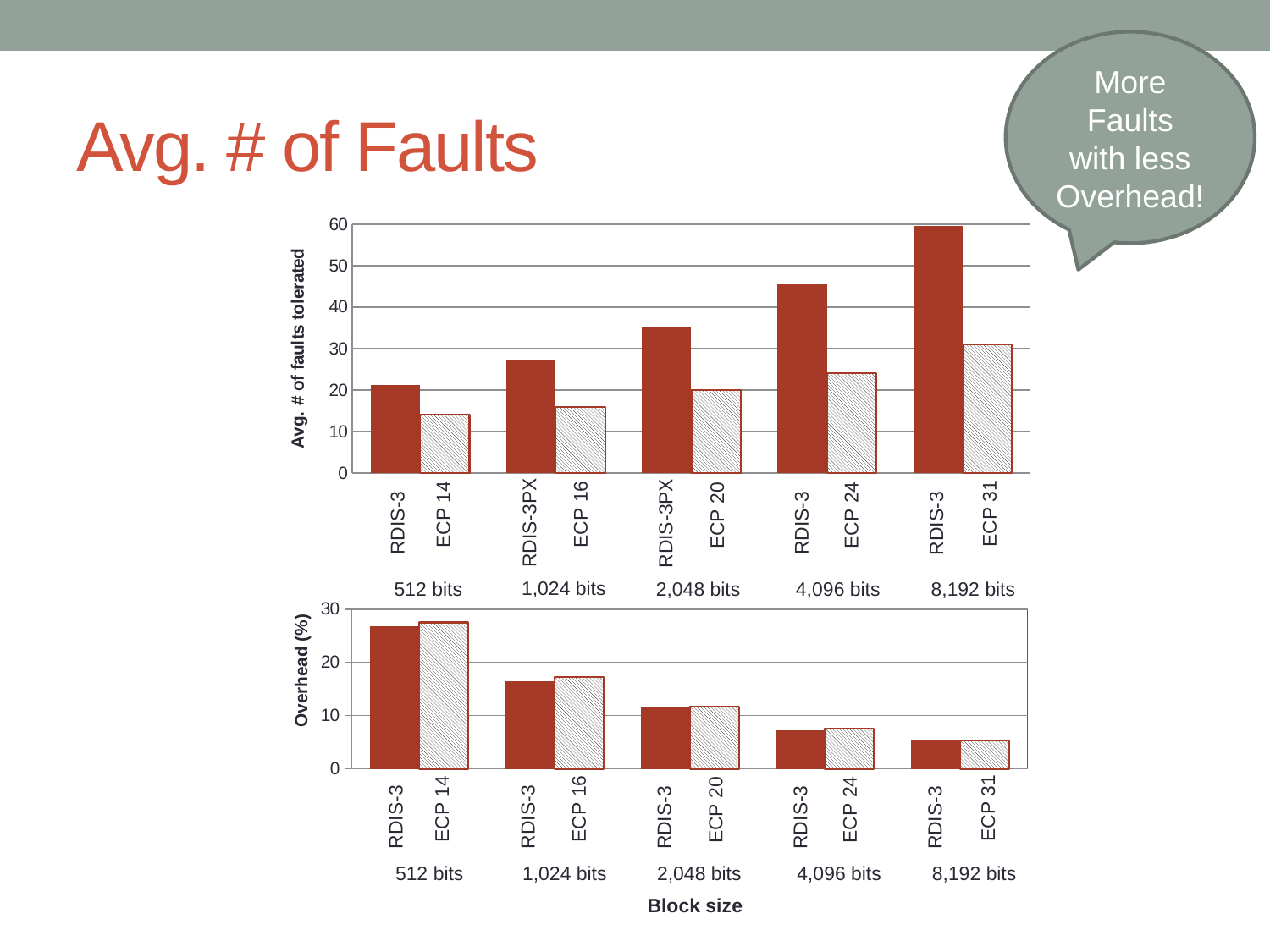
In the top chart (Avg. # of faults tolerated), at 4,096 bits, which tolerates more faults: RDIS-3 or ECP 24? RDIS-3 In the top chart (Avg. # of faults tolerated), is the value for RDIS-3 at 8,192 bits greater or less than 50? greater In the top chart (Avg. # of faults tolerated), how many block sizes are shown along the x axis? 5 What is the x-axis title shown below the bottom chart? Block size In the top chart (Avg. # of faults tolerated), which bar is the lowest? ECP 14 at 512 bits In the bottom chart (Overhead (%)), does overhead rise or fall as block size increases? fall What kind of chart is the top chart (Avg. # of faults tolerated)? bar chart In the bottom chart (Overhead (%)), is the value for RDIS-3 at 512 bits greater or less than 20? greater In the top chart (Avg. # of faults tolerated), do the RDIS bars rise or fall as block size increases? rise In the bottom chart (Overhead (%)), is the value for ECP 31 at 8,192 bits greater or less than 10? less In the top chart (Avg. # of faults tolerated), which bar is the highest? RDIS-3 at 8,192 bits